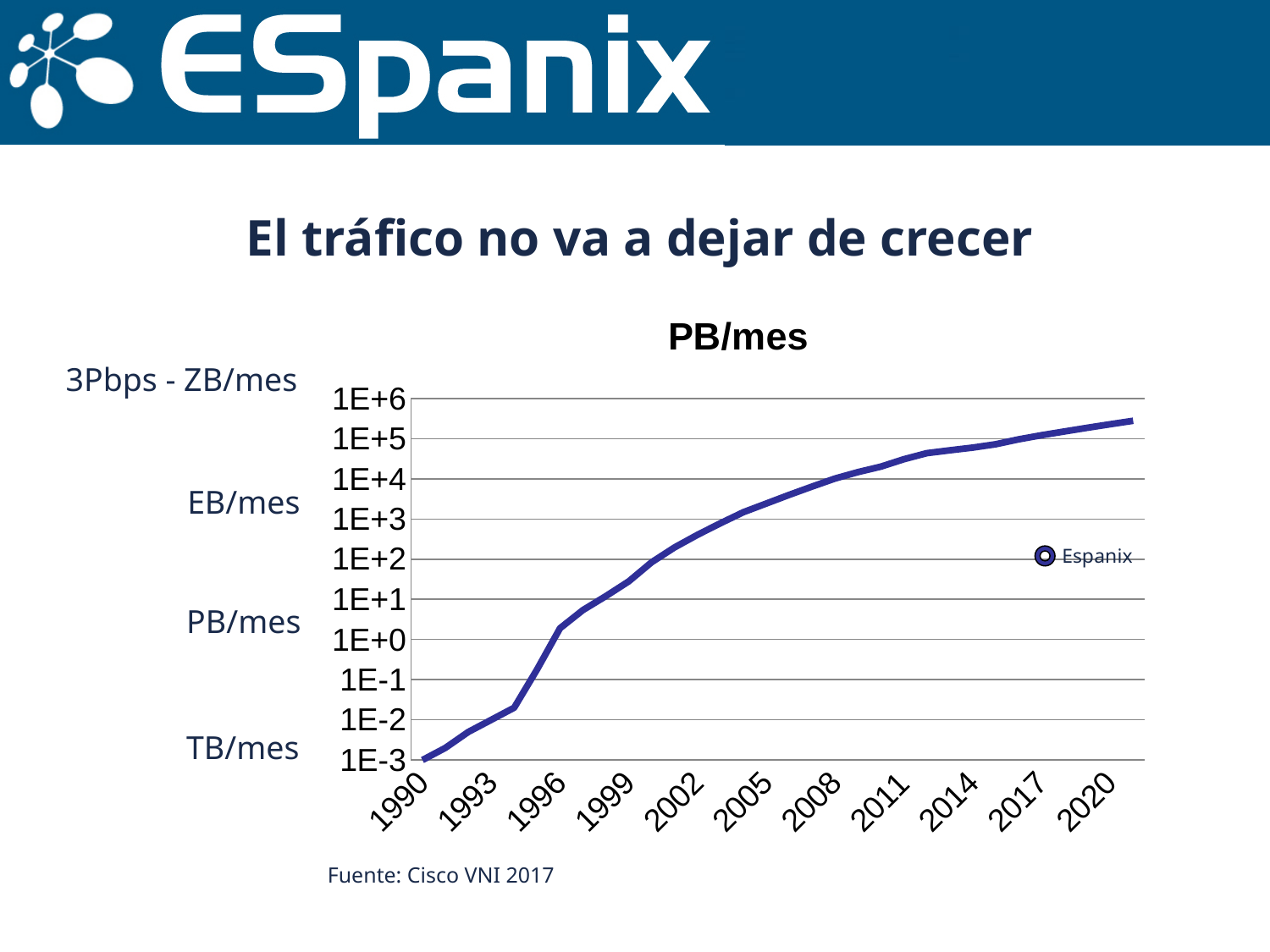
Which year on the x axis has the lowest value? 1990 Do the values rise or fall along the x axis from 1990 to 2020? rise Which year on the x axis has the highest value? 2020 Which has the larger value, 1999 or 2005? 2005 Is the value for 1996 greater or less than 1E+1? less What kind of chart is shown on the slide? line chart How many series does the chart legend list? 1 Is the value for 1990 greater or less than 1E-2? less Is the value for 2020 greater or less than 1E+5? greater What is the title of the chart? PB/mes What is the name of the series shown in the legend? Espanix